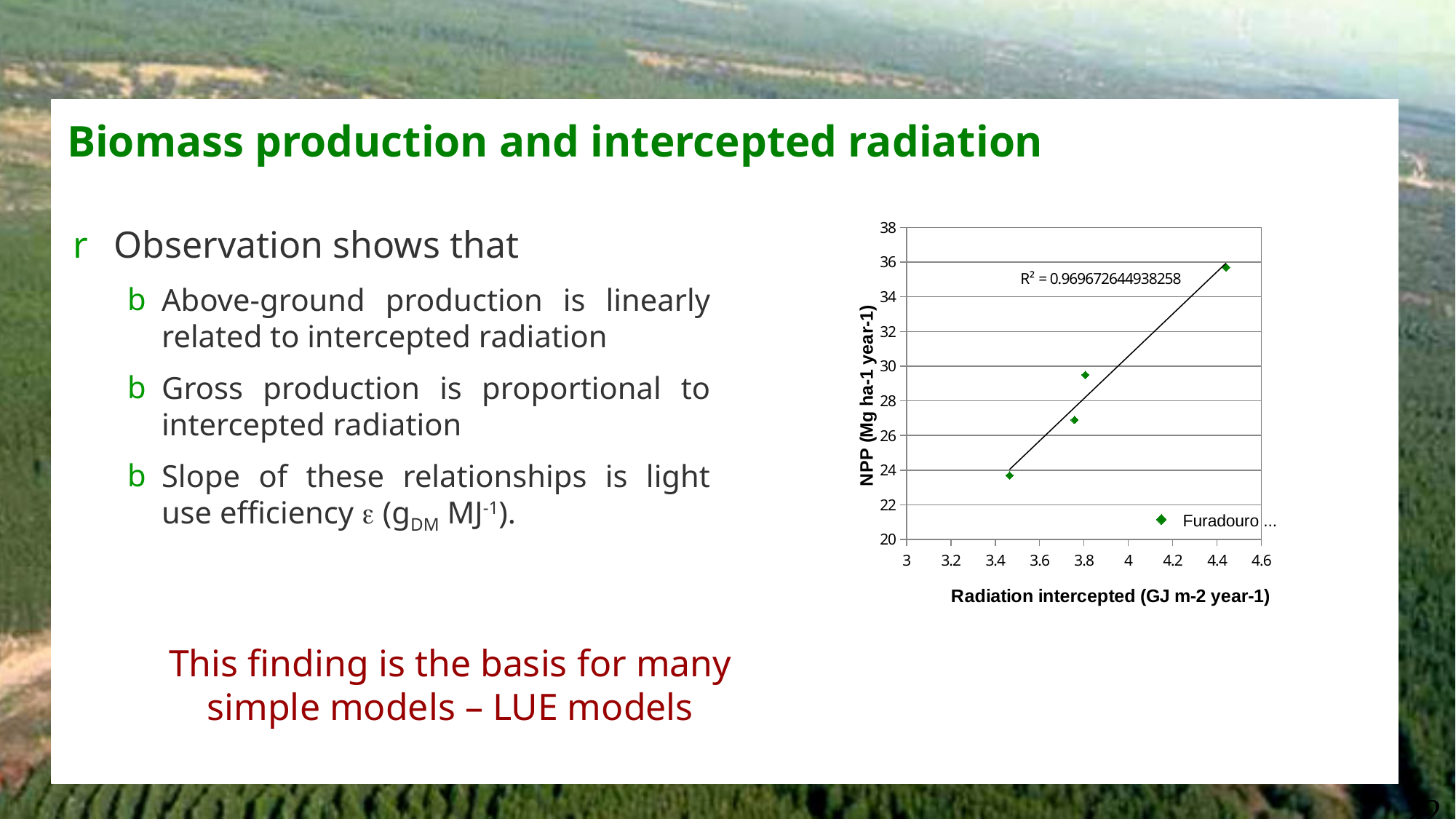
How many series does the chart legend list? 1 What R-squared value is printed on the chart? R² = 0.969672644938258 How many data points are plotted in the chart? 4 Do the NPP values rise or fall as radiation intercepted increases along the x axis? rise What is the title of the x axis of the chart? Radiation intercepted (GJ m-2 year-1) Is the NPP value of the rightmost data point (near 4.4 GJ m-2 year-1) greater or less than 34? greater Which data point has the highest NPP: the one near 3.4 or the one near 4.4 GJ m-2 year-1 on the x axis? the one near 4.4 Is the NPP value of the highest data point greater or less than 30? greater What kind of chart is shown on the slide? scatter chart Is the NPP value of the lowest data point greater or less than 22? greater